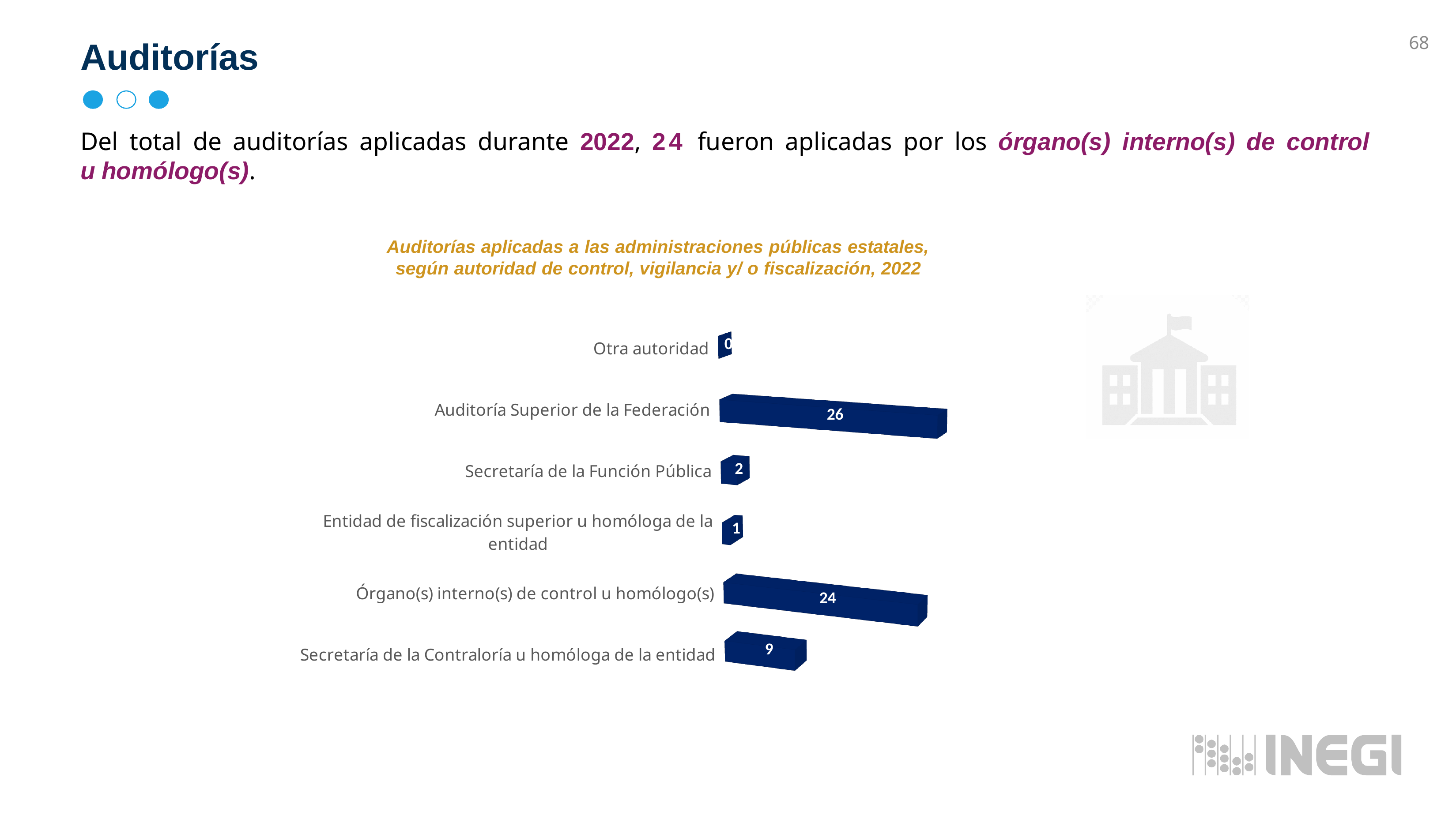
What is the value for Secretaría de la Función Pública? 2 Which is larger, the value for Secretaría de la Contraloría u homóloga de la entidad or the value for Secretaría de la Función Pública? Secretaría de la Contraloría u homóloga de la entidad Which category has the highest value? Auditoría Superior de la Federación What is the value for Otra autoridad? 0 How many categories are shown in the chart? 6 What is the value for Auditoría Superior de la Federación? 26 What is the value for Entidad de fiscalización superior u homóloga de la entidad? 1 What is the difference between the values for Auditoría Superior de la Federación and Órgano(s) interno(s) de control u homólogo(s)? 2 What kind of chart is shown on the slide? Bar chart What is the value for Secretaría de la Contraloría u homóloga de la entidad? 9 Which category has the lowest value? Otra autoridad What is the value for Órgano(s) interno(s) de control u homólogo(s)? 24